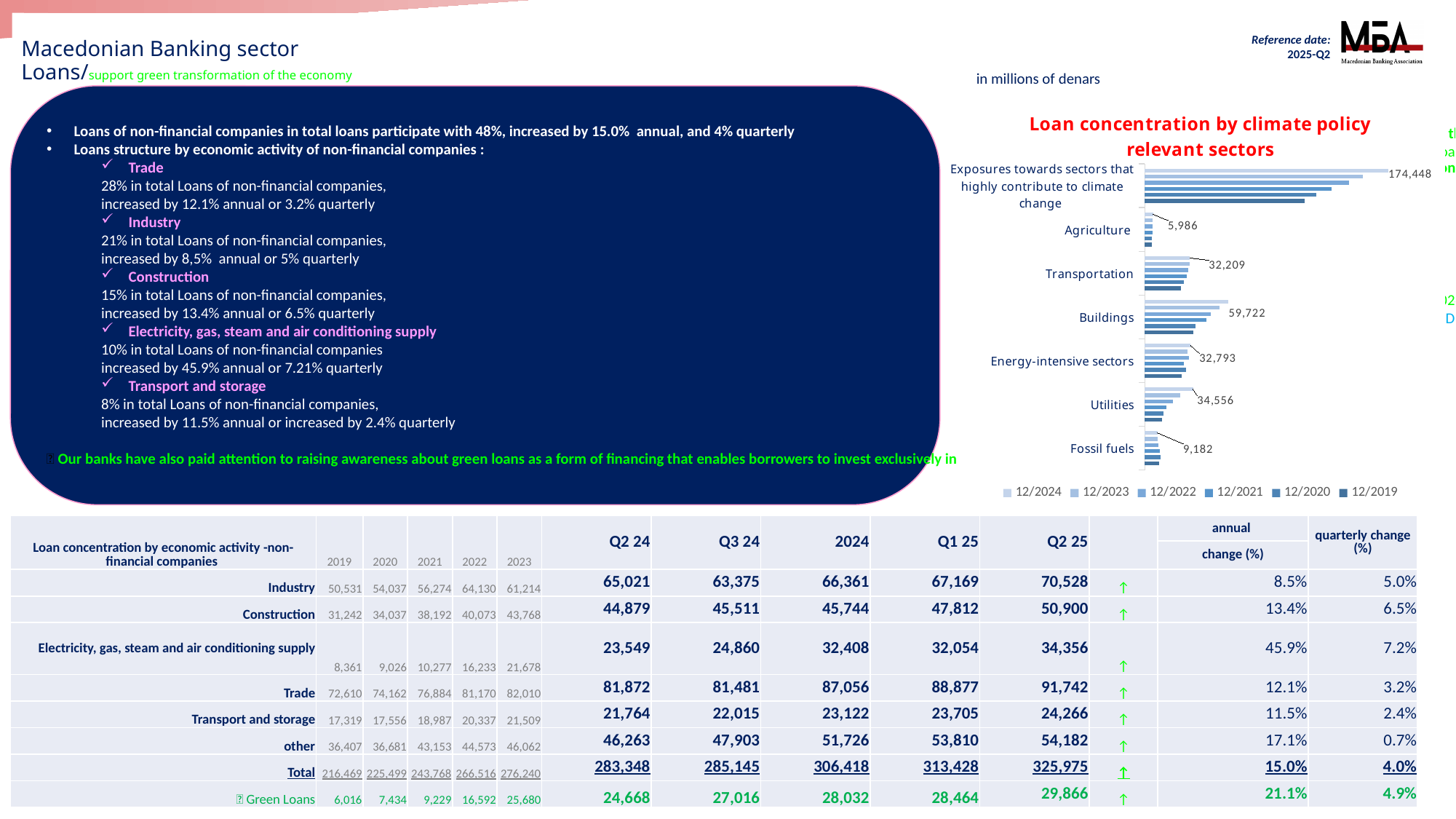
What is the title of the bar chart on the slide? Loan concentration by climate policy relevant sectors In the 'Loan concentration by climate policy relevant sectors' chart, what is the 12/2024 value for Agriculture? 5,986 In the 'Loan concentration by climate policy relevant sectors' chart, what is the 12/2024 value for Fossil fuels? 9,182 In the 'Loan concentration by climate policy relevant sectors' chart, which category has the highest 12/2024 value? Exposures towards sectors that highly contribute to climate change In the 'Loan concentration by climate policy relevant sectors' chart, which category has the lowest 12/2024 value? Agriculture How many series does the legend of the 'Loan concentration by climate policy relevant sectors' chart list? 6 In the 'Loan concentration by climate policy relevant sectors' chart, what is the difference between the 12/2024 values for Buildings and Transportation? 27,513 In the 'Loan concentration by climate policy relevant sectors' chart, what is the 12/2024 value for Exposures towards sectors that highly contribute to climate change? 174,448 In the 'Loan concentration by climate policy relevant sectors' chart, what is the 12/2024 value for Buildings? 59,722 How many categories are shown in the 'Loan concentration by climate policy relevant sectors' chart? 7 In the 'Loan concentration by climate policy relevant sectors' chart, which has the larger 12/2024 value, Buildings or Utilities? Buildings What type of chart is 'Loan concentration by climate policy relevant sectors'? bar chart